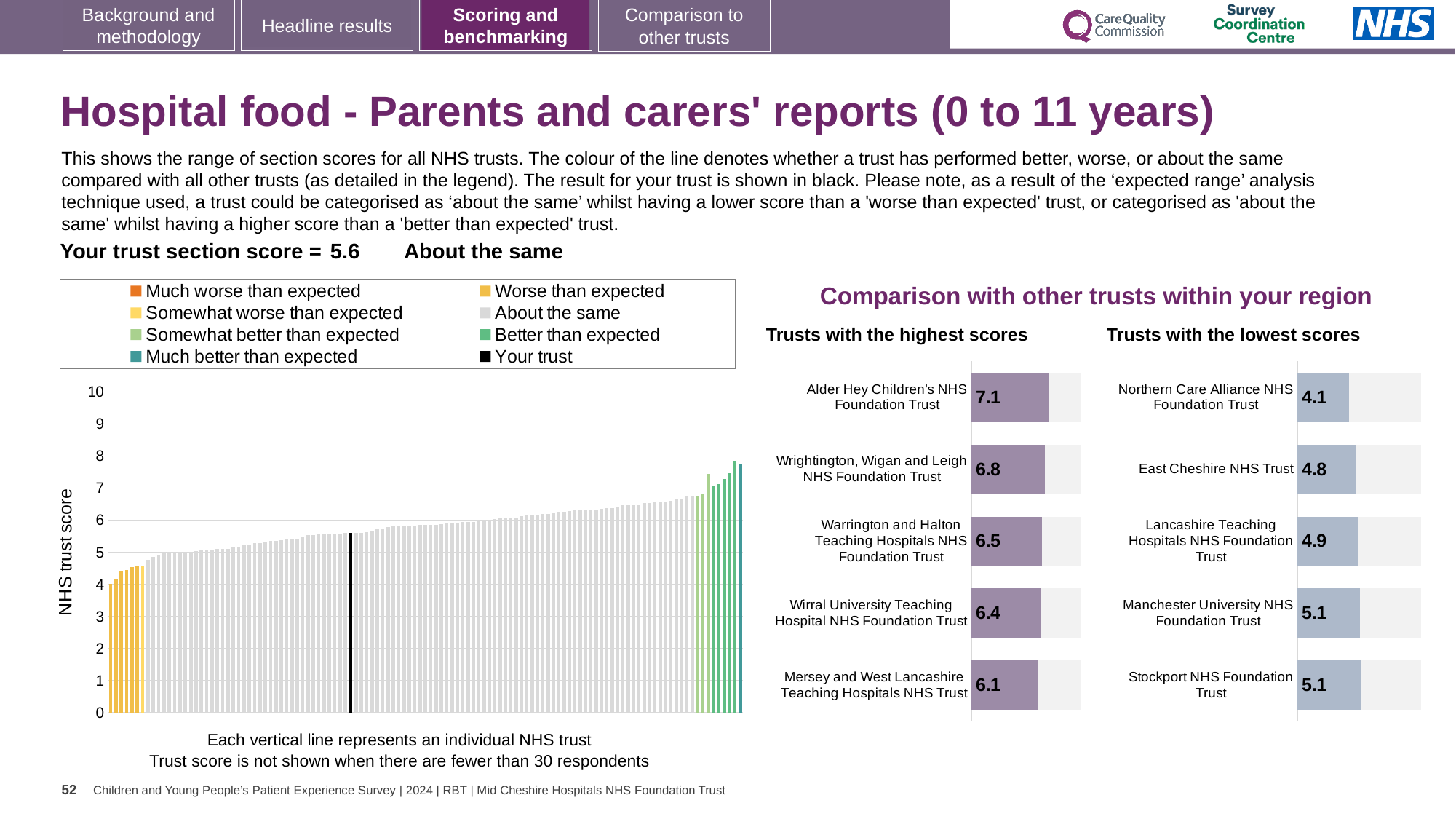
In the 'NHS trust score' chart on the left, do the bar values rise or fall from left to right? Rise In the 'NHS trust score' chart on the left, is the value of the tallest bar greater or less than 7? greater In the 'Trusts with the lowest scores' chart, which trust has the lowest score? Northern Care Alliance NHS Foundation Trust How many entries does the legend of the 'NHS trust score' chart on the left list? 8 In the 'Trusts with the highest scores' chart, what is the difference between the scores of Alder Hey Children's NHS Foundation Trust and Mersey and West Lancashire Teaching Hospitals NHS Trust? 1.0 What type of chart is the 'NHS trust score' chart on the left of the slide? Bar chart Which has the higher score: Wrightington, Wigan and Leigh NHS Foundation Trust in the highest-scores chart, or East Cheshire NHS Trust in the lowest-scores chart? Wrightington, Wigan and Leigh NHS Foundation Trust In the 'Trusts with the lowest scores' chart, what is the score for Northern Care Alliance NHS Foundation Trust? 4.1 How many trusts are listed in the 'Trusts with the lowest scores' chart? 5 In the 'Trusts with the highest scores' chart, what is the score for Alder Hey Children's NHS Foundation Trust? 7.1 In the 'Trusts with the lowest scores' chart, what is the difference between the scores of Stockport NHS Foundation Trust and Northern Care Alliance NHS Foundation Trust? 1.0 In the 'Trusts with the highest scores' chart, which trust has the lowest score shown? Mersey and West Lancashire Teaching Hospitals NHS Trust